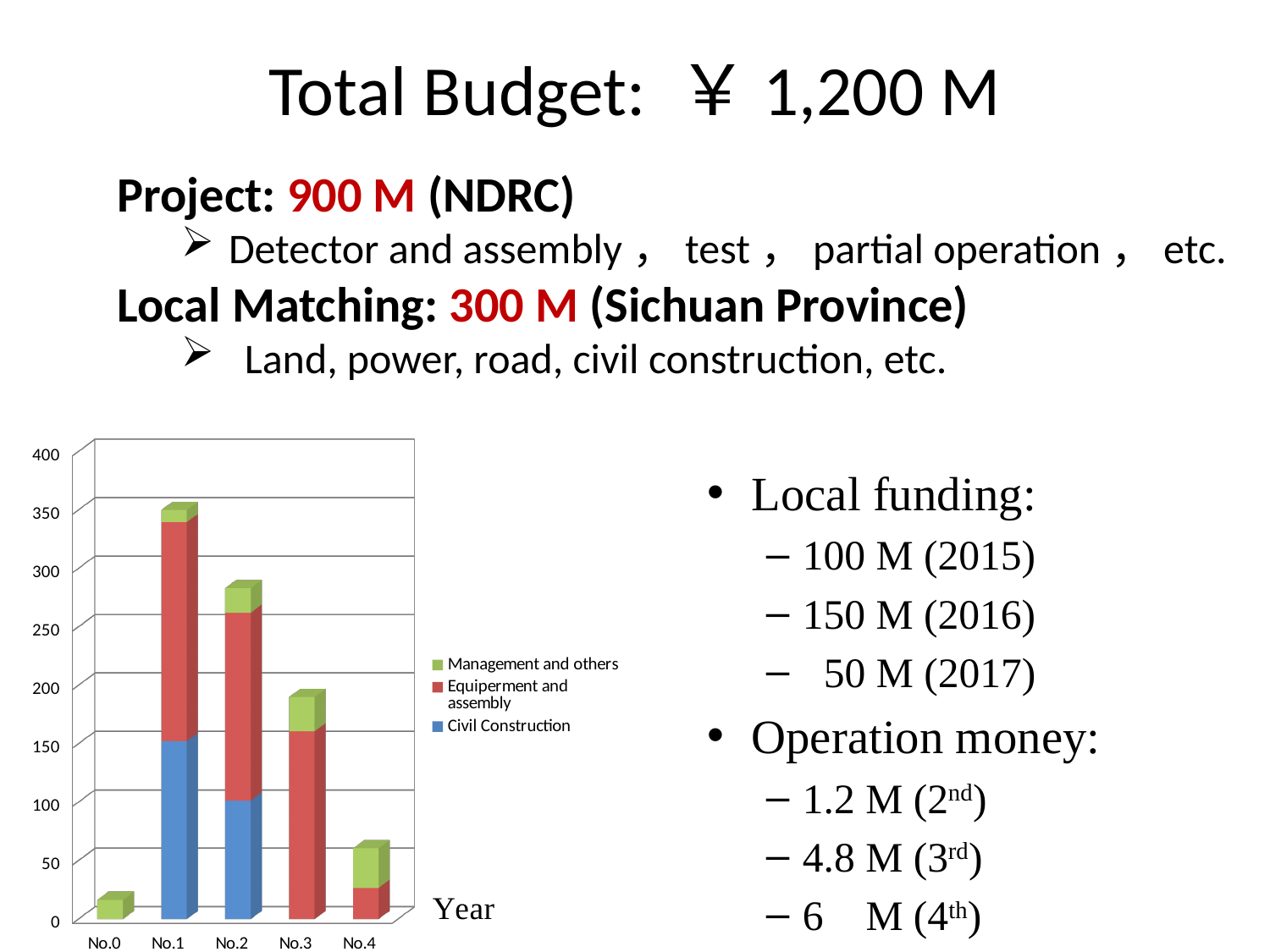
How many categories are shown on the x axis of the chart? 5 Which category has the shortest stacked bar? No.0 What kind of chart is shown on the slide? Stacked bar chart What label is shown for the x axis of the chart? Year Which category has the tallest stacked bar? No.1 Which has the larger stacked total, No.1 or No.2? No.1 How many series does the chart legend list? 3 Is the total for No.3 greater or less than 200? less Is the total for No.4 greater or less than 100? less Is the total for No.1 greater or less than 300? greater From No.1 to No.4, do the stacked bar totals rise or fall? fall